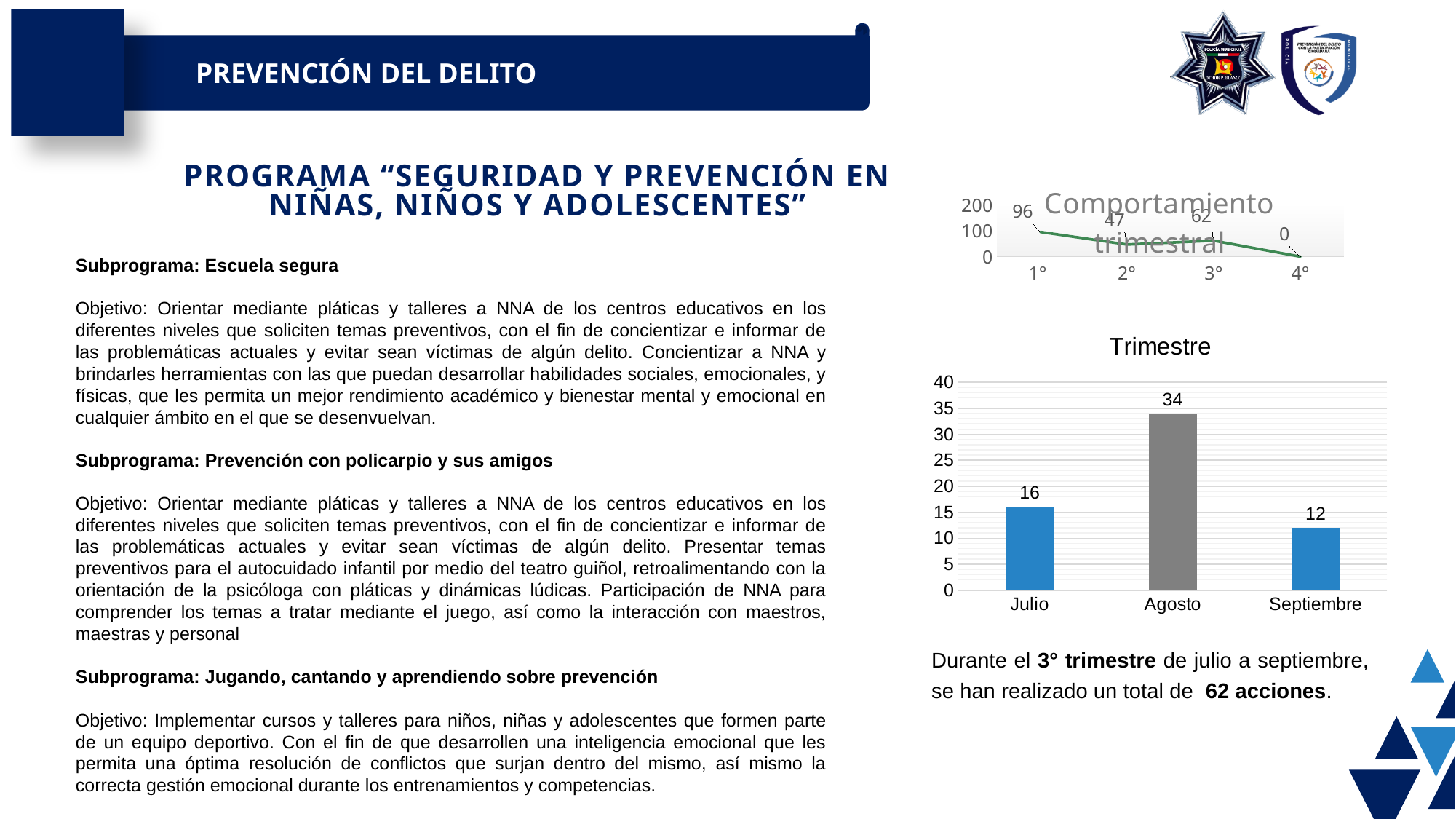
In the "Trimestre" bar chart, what is the value for Agosto? 34 What kind of chart is the "Trimestre" chart? bar chart In the "Trimestre" bar chart, which month has the highest value? Agosto In the "Trimestre" bar chart, how many months are shown? 3 In the "Comportamiento trimestral" chart, what is the value for 1°? 96 What kind of chart is the "Comportamiento trimestral" chart? line chart In the "Trimestre" bar chart, which month has the lowest value? Septiembre In the "Trimestre" bar chart, what is the value for Septiembre? 12 In the "Comportamiento trimestral" chart, which quarter has the highest value? 1° In the "Comportamiento trimestral" chart, is the value for 2° larger or smaller than the value for 3°? smaller In the "Comportamiento trimestral" chart, what is the value for 3°? 62 In the "Trimestre" bar chart, what is the difference between the values for Agosto and Julio? 18